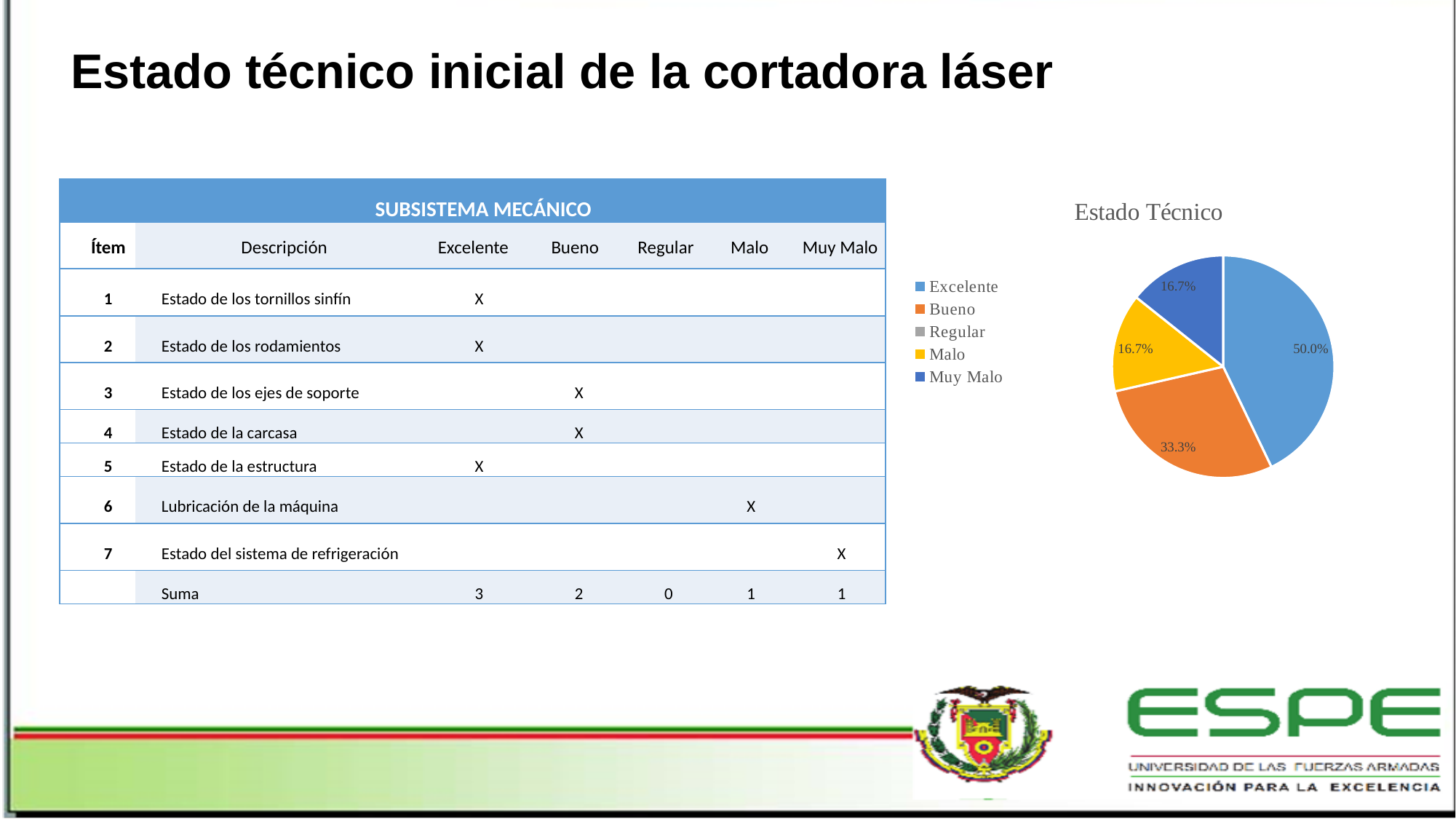
Which category has the largest slice in the Estado Técnico pie chart? Excelente In the Estado Técnico pie chart, what share is labelled for Excelente? 50.0% In the Estado Técnico pie chart, what share is labelled for Bueno? 33.3% What kind of chart is shown on the slide? pie chart How many entries does the legend of the Estado Técnico pie chart list? 5 What is the title of the pie chart? Estado Técnico In the Estado Técnico pie chart, what share is labelled for Malo? 16.7% How many slices with a percentage label are visible in the Estado Técnico pie chart? 4 Which legend entry of the Estado Técnico pie chart has no visible slice in the pie? Regular In the Estado Técnico pie chart, what is the difference between the Excelente share and the Bueno share? 16.7% In the Estado Técnico pie chart, which slice is larger, Excelente or Bueno? Excelente In the Estado Técnico pie chart, what share is labelled for Muy Malo? 16.7%